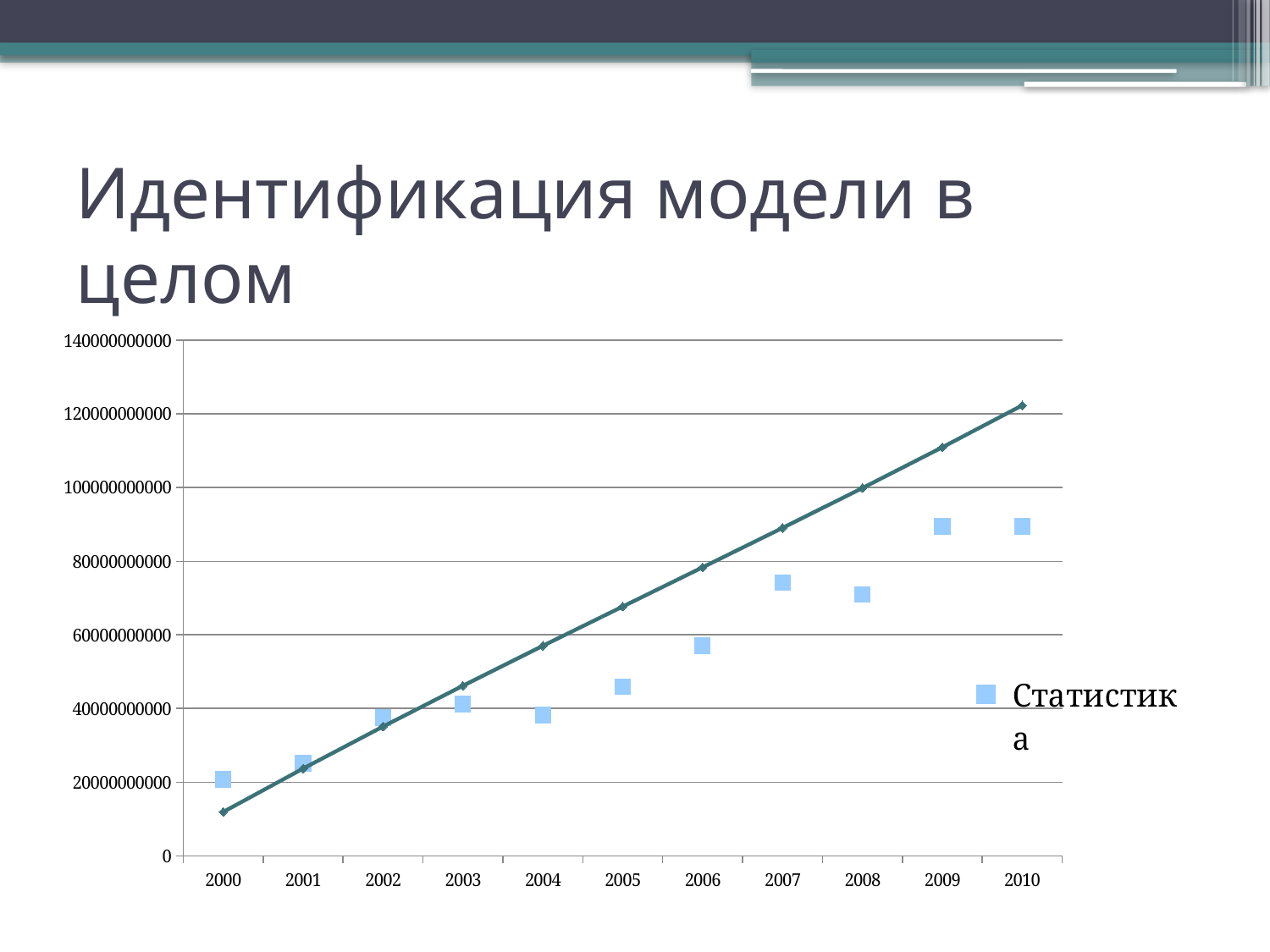
How many years are shown along the x axis of the chart? 11 Is the Статистика value for 2000 greater or less than 40000000000? less Is the Статистика value for 2010 greater or less than 80000000000? greater How many series does the chart's legend list? 1 What kind of chart is shown on the slide? line chart What is the name of the series listed in the chart's legend? Статистика Is the Статистика value for 2007 greater or less than 60000000000? greater Does the line series rise or fall from 2000 to 2010? rise Which year has a larger Статистика value, 2005 or 2009? 2009 Which year has the lowest Статистика value? 2000